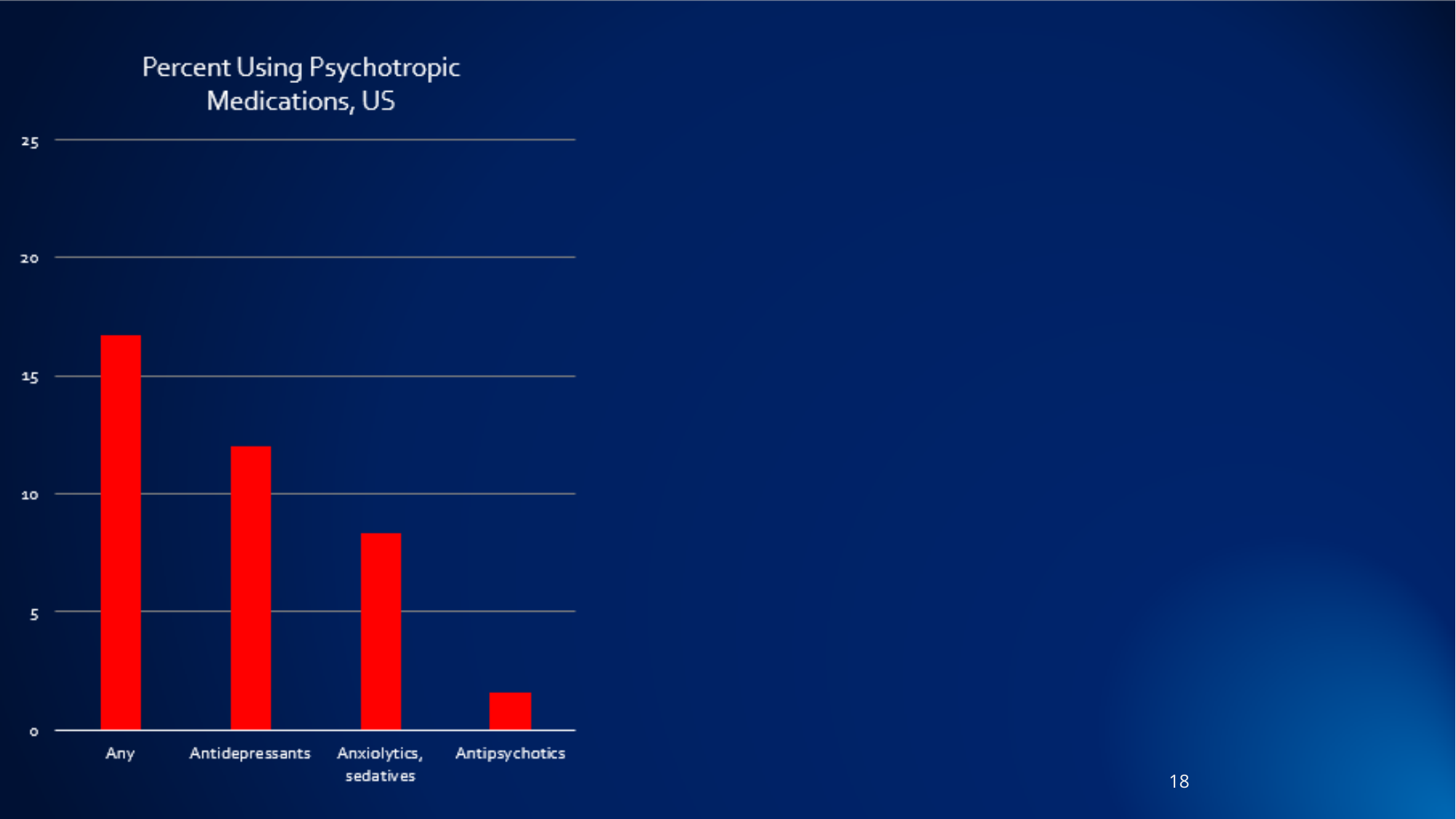
What is the title of the chart? Percent Using Psychotropic Medications, US Is the value for Antidepressants greater or less than 10? greater Which category has the lowest value in the chart? Antipsychotics Is the value for Any greater or less than 15? greater Which is larger, the value for Antidepressants or the value for Anxiolytics, sedatives? Antidepressants How many categories are shown on the x axis of the chart? 4 Is the value for Antipsychotics greater or less than 5? less Do the bar values rise or fall from left to right along the x axis? fall Which category has the highest value in the chart? Any What kind of chart is shown on the slide? bar chart Which is larger, the value for Antipsychotics or the value for Anxiolytics, sedatives? Anxiolytics, sedatives